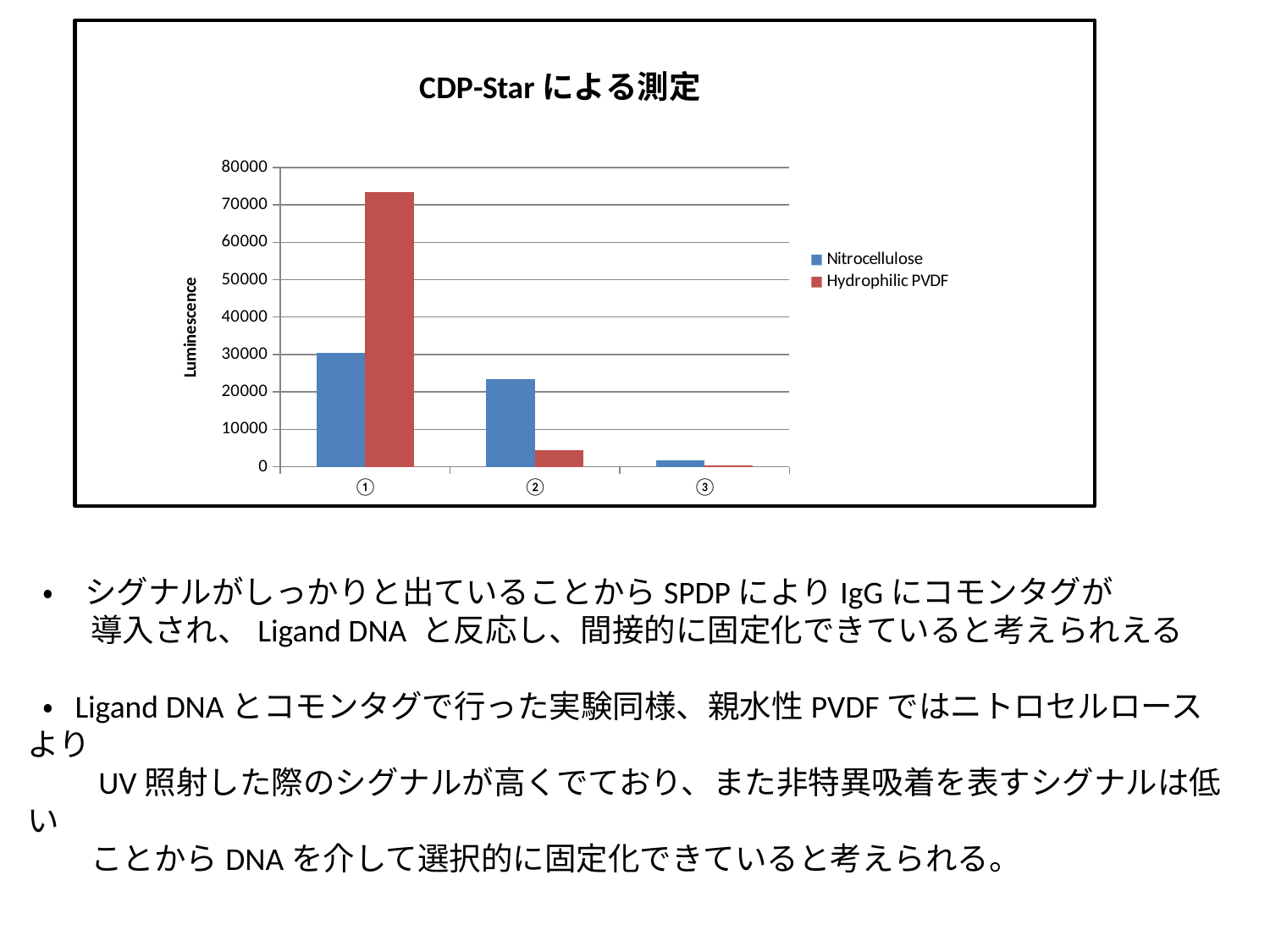
Which category has the lowest Nitrocellulose value? ③ Is the Hydrophilic PVDF value for ① greater or less than 70000? greater For category ①, which series has the larger value, Nitrocellulose or Hydrophilic PVDF? Hydrophilic PVDF For category ②, which series has the larger value, Nitrocellulose or Hydrophilic PVDF? Nitrocellulose What is the label of the y axis? Luminescence How many categories are shown on the x axis? 3 What kind of chart is shown on the slide? Bar chart Which category has the highest Hydrophilic PVDF value? ① Is the Hydrophilic PVDF value for ② greater or less than 10000? less Is the Nitrocellulose value for ② greater or less than 20000? greater Do the Nitrocellulose values rise or fall from ① to ③? fall How many series does the legend list? 2